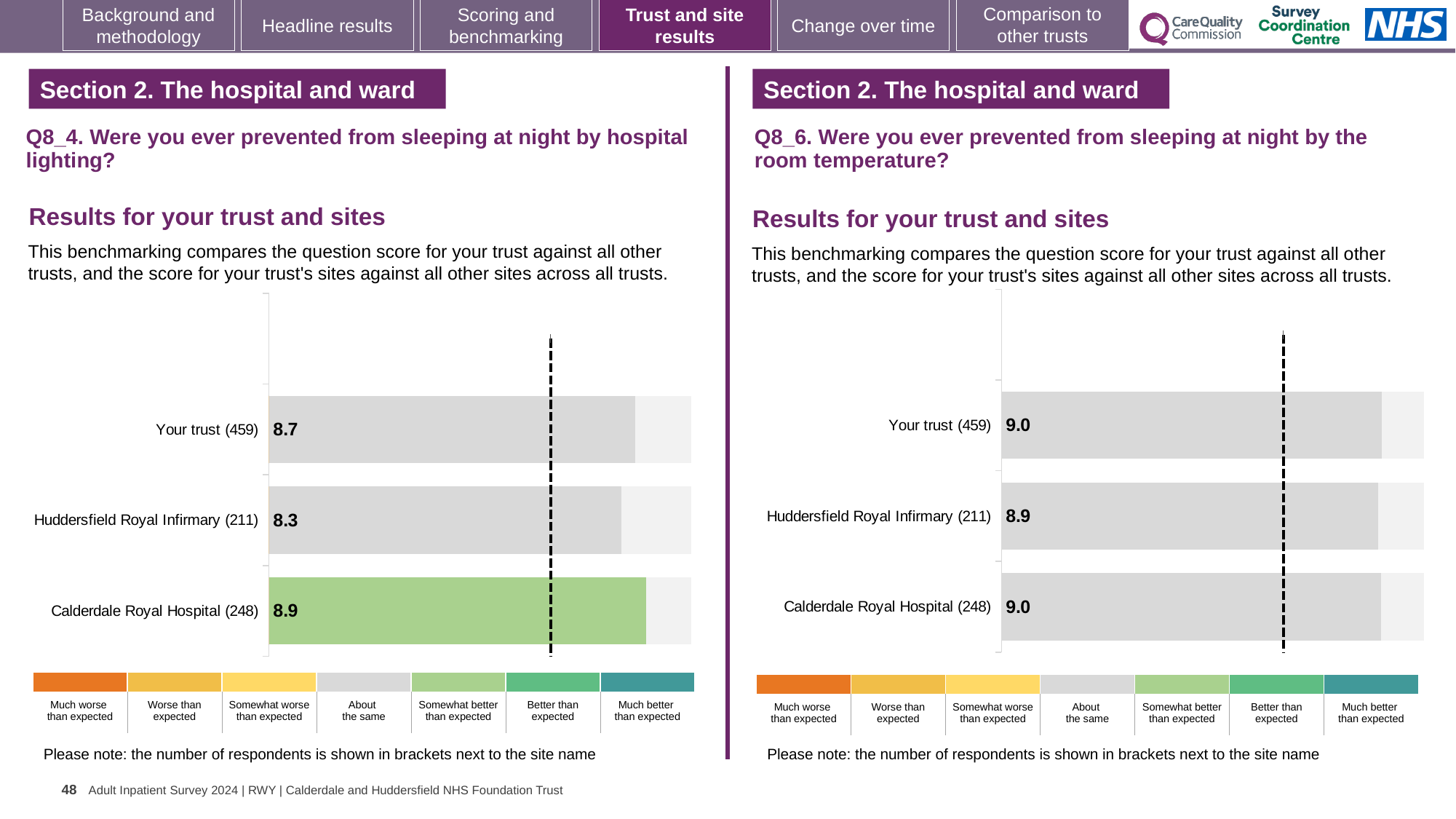
In the Q8_6 chart (room temperature), what is the score for Calderdale Royal Hospital? 9.0 In the Q8_4 chart (hospital lighting), what is the score for Calderdale Royal Hospital? 8.9 In the Q8_4 chart (hospital lighting), what is the score for Huddersfield Royal Infirmary? 8.3 In the Q8_4 chart (hospital lighting), which site or trust has the lowest score? Huddersfield Royal Infirmary In the Q8_4 chart (hospital lighting), what is the difference between the scores for Calderdale Royal Hospital and Huddersfield Royal Infirmary? 0.6 In the Q8_4 chart (hospital lighting), what is the score for Your trust? 8.7 In the Q8_4 chart (hospital lighting), which benchmark category does the green bar for Calderdale Royal Hospital indicate? Somewhat better than expected In the Q8_6 chart (room temperature), what is the score for Your trust? 9.0 In the Q8_6 chart (room temperature), what is the score for Huddersfield Royal Infirmary? 8.9 In the Q8_4 chart (hospital lighting), which site or trust has the highest score? Calderdale Royal Hospital What kind of chart is used in the Q8_4 chart (hospital lighting)? Bar chart In the Q8_6 chart (room temperature), how many bars are plotted? 3